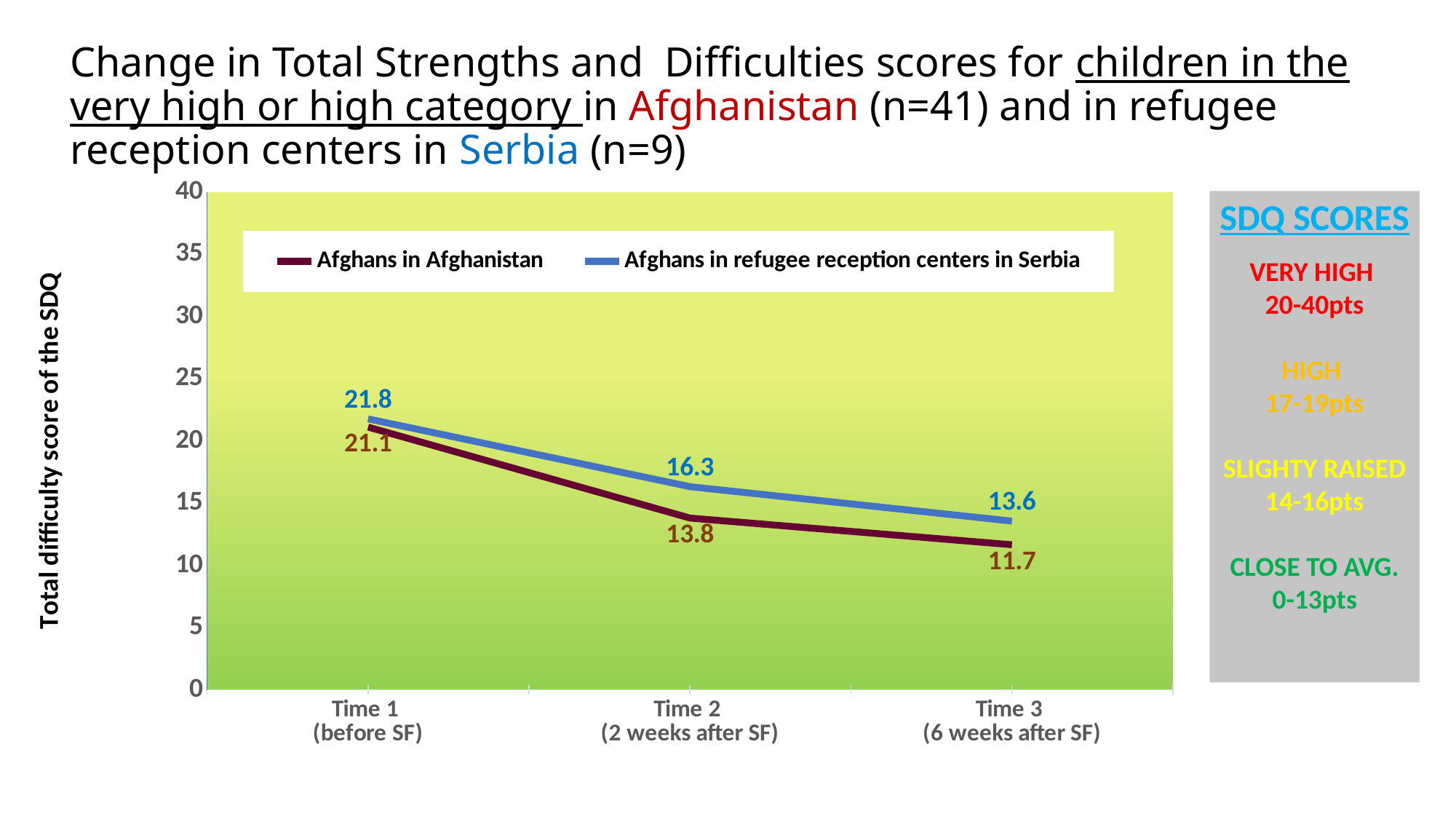
At which time point is the value for Afghans in Afghanistan highest? Time 1 (before SF) What is the difference between the Time 1 and Time 3 values for Afghans in Afghanistan? 9.4 At which time point is the value for Afghans in refugee reception centers in Serbia lowest? Time 3 (6 weeks after SF) What kind of chart is shown on the slide? Line chart What is the value for Afghans in Afghanistan at Time 1 (before SF)? 21.1 What is the value for Afghans in refugee reception centers in Serbia at Time 2 (2 weeks after SF)? 16.3 How many series does the legend list? 2 What is the value for Afghans in Afghanistan at Time 3 (6 weeks after SF)? 11.7 What is the value for Afghans in refugee reception centers in Serbia at Time 3 (6 weeks after SF)? 13.6 Which series has the larger value at Time 3 (6 weeks after SF)? Afghans in refugee reception centers in Serbia What is the difference between the two series at Time 2 (2 weeks after SF)? 2.5 How many time points are plotted on the x axis? 3